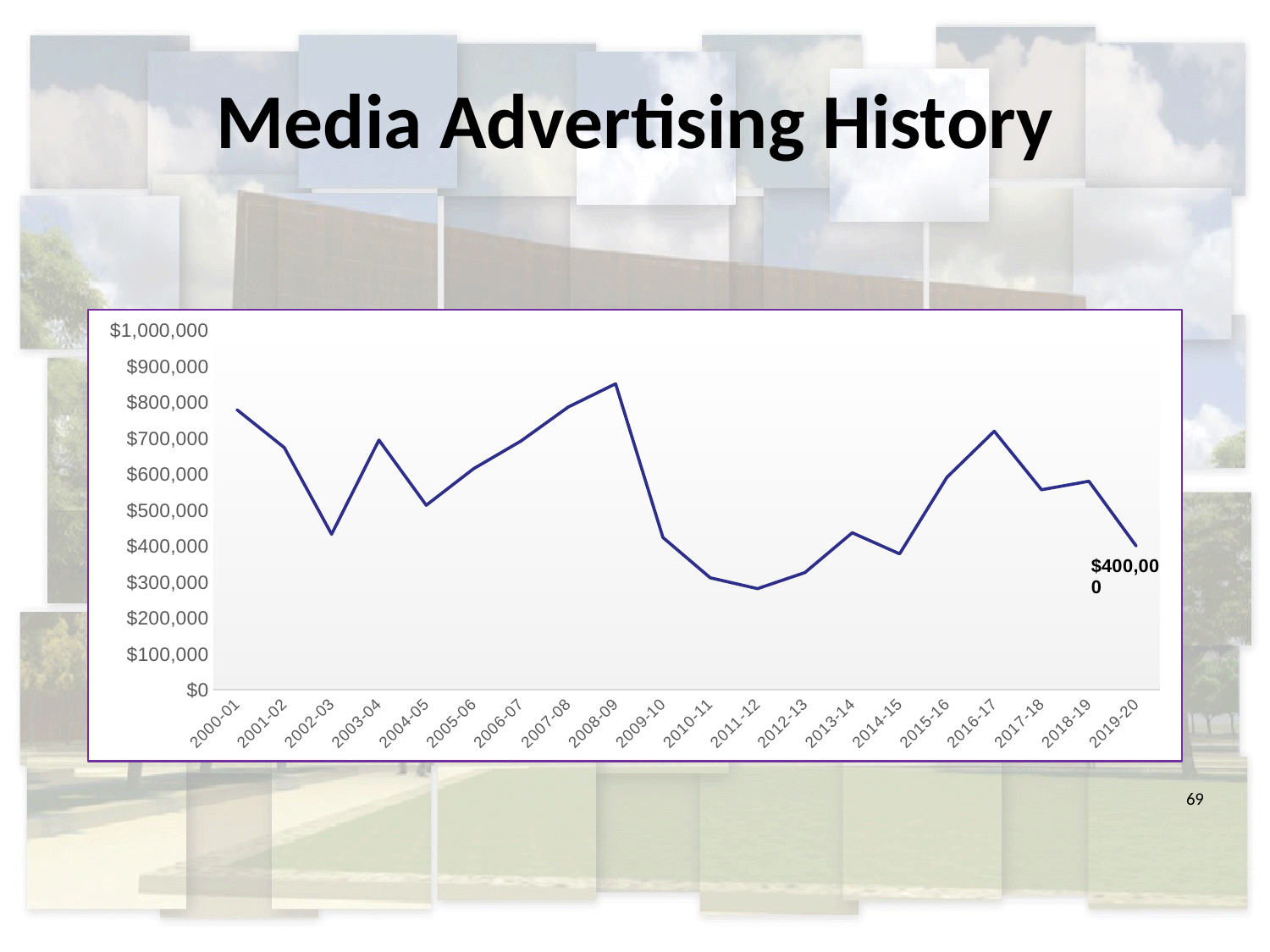
Is the value for 2008-09 greater or less than $800,000? greater Which is larger, the value for 2000-01 or the value for 2019-20? 2000-01 What is the title of the slide containing the chart? Media Advertising History Which year has the lowest media advertising value? 2011-12 Which is larger, the value for 2008-09 or the value for 2016-17? 2008-09 Is the value for 2010-11 greater or less than $400,000? less Do the values rise or fall from 2008-09 to 2011-12? fall How many years are plotted on the x axis? 20 Is the value for 2002-03 greater or less than $500,000? less What is the media advertising value for 2019-20? $400,000 Which year has the highest media advertising value? 2008-09 What type of chart is shown on the slide? line chart